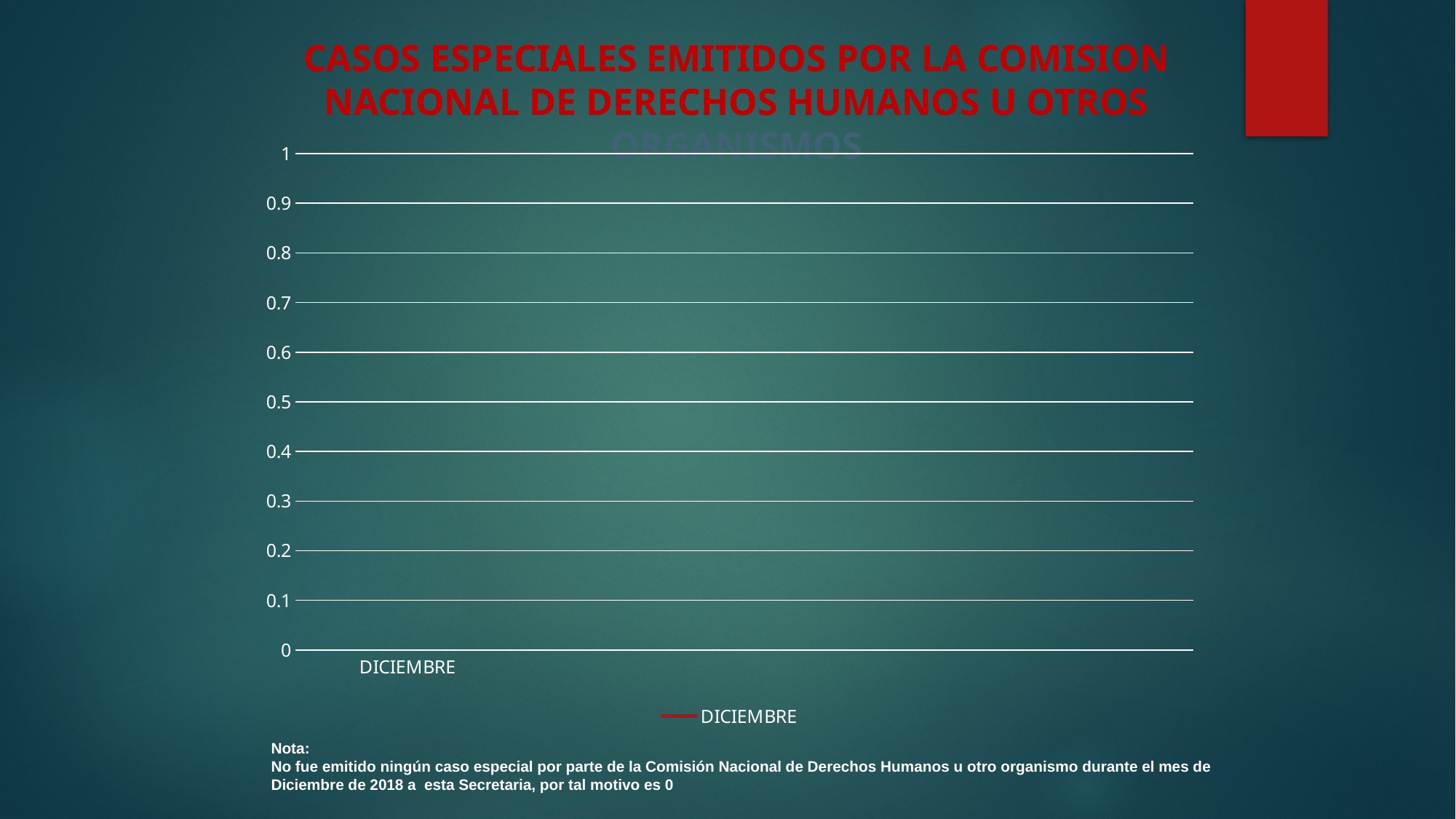
How many categories are shown on the x axis of the chart? 1 What is the highest value shown on the chart's y axis? 1 What is the name of the series listed in the chart's legend? DICIEMBRE How many series does the chart's legend list? 1 What is the only category label on the x axis of the chart? DICIEMBRE Is the value for DICIEMBRE greater or less than 0.5? less According to the note on the slide, what is the value for DICIEMBRE? 0